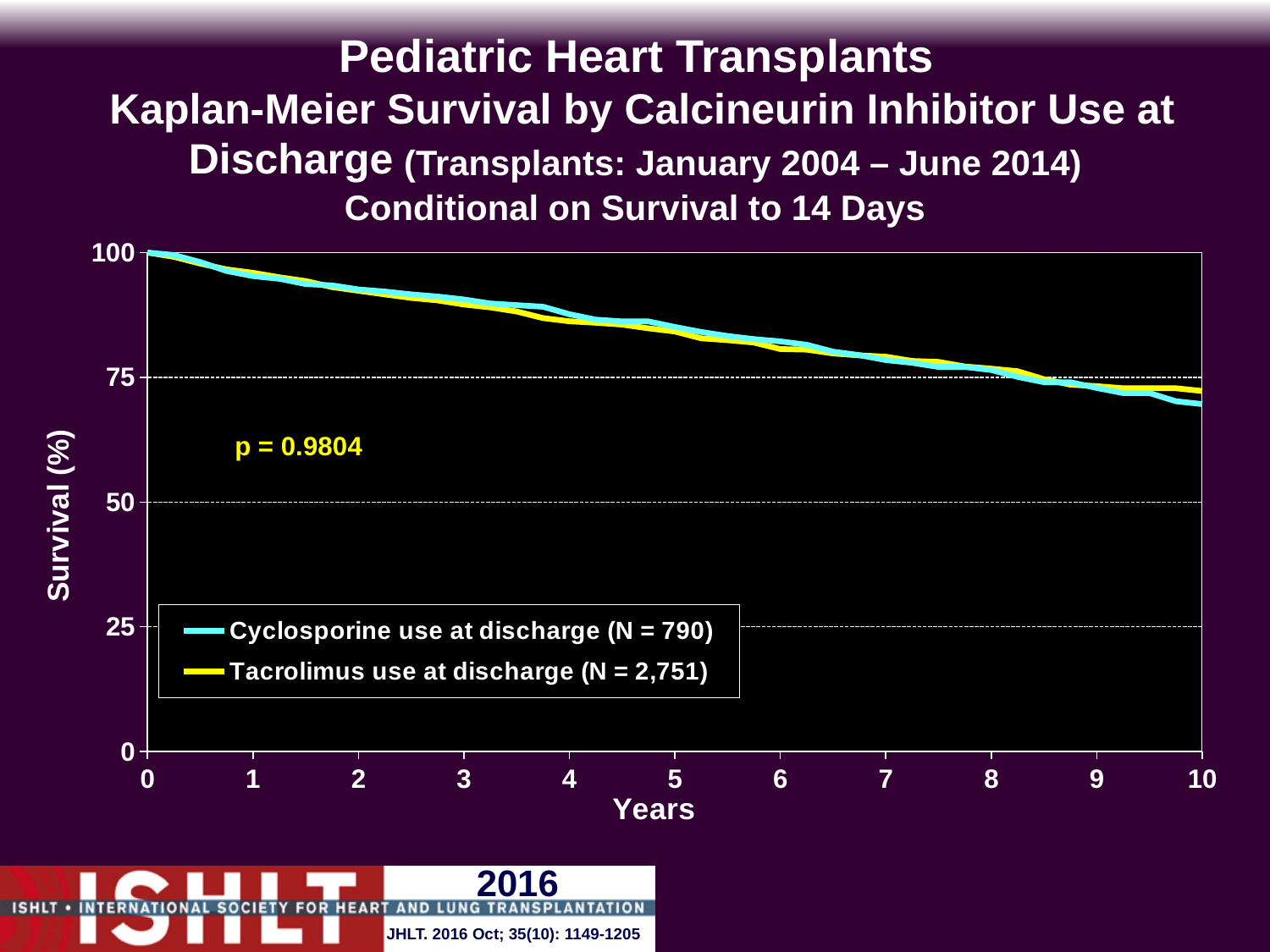
Is the survival value for Cyclosporine use at discharge at 2 years greater or less than 75? greater What is the N shown in the legend for Tacrolimus use at discharge? 2,751 How many series does the legend list? 2 Is the survival value for Cyclosporine use at discharge at 10 years greater or less than 75? less What p-value is shown on the chart? p = 0.9804 Is the survival value for Tacrolimus use at discharge at 1 year greater or less than 75? greater What kind of chart is shown on the slide? line chart Do the survival curves rise or fall as the years increase? fall